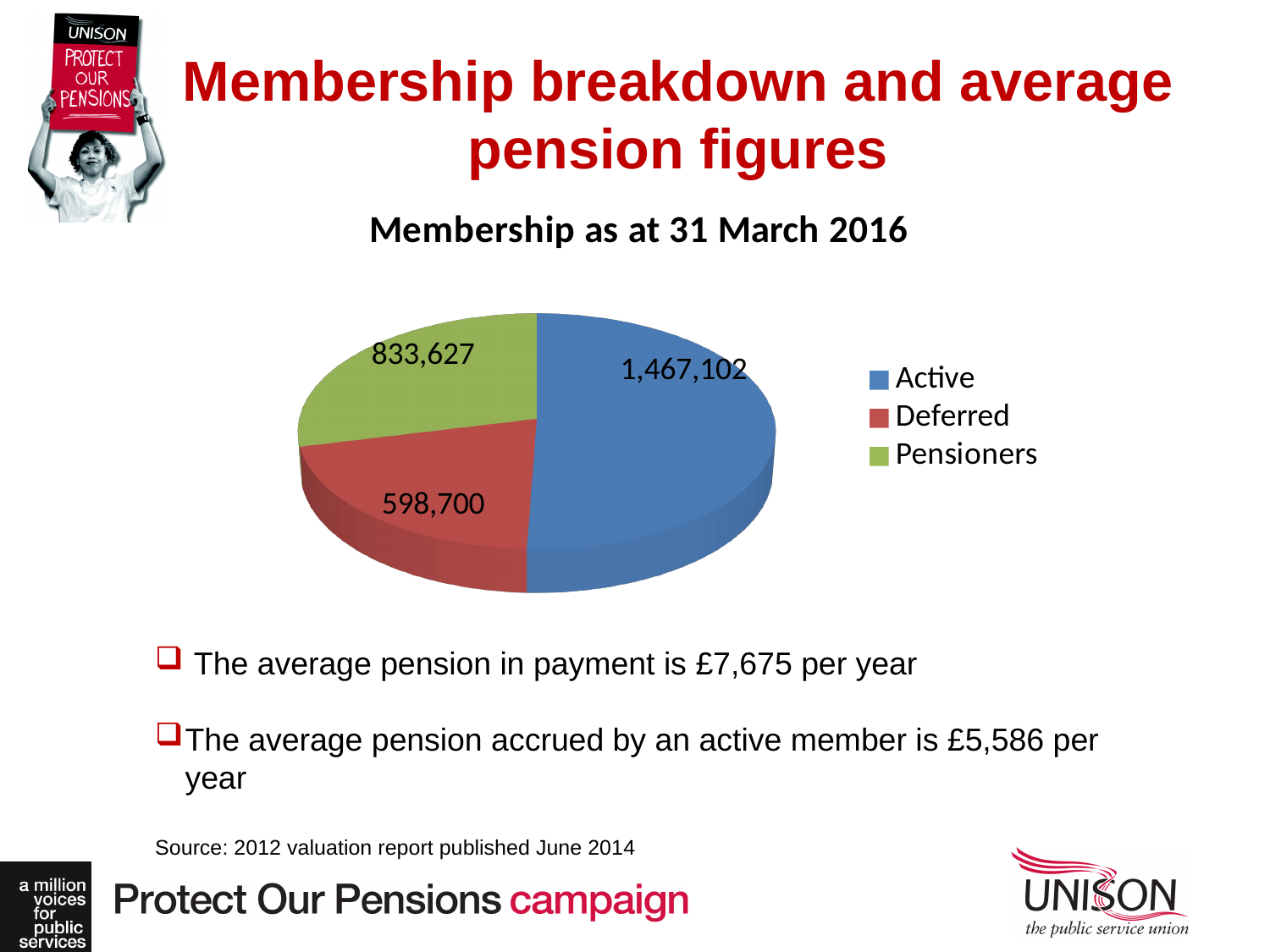
What colour is the Pensioners slice in the pie chart? Green How many slices does the pie chart have? 3 Which category has the largest slice of the pie? Active Which is larger, the value for Pensioners or the value for Deferred? Pensioners What is the value shown for Active members? 1,467,102 What is the difference between the Active value and the Deferred value? 868,402 What type of chart is shown on the slide? Pie chart What is the title of the chart? Membership as at 31 March 2016 How many entries does the chart legend list? 3 What is the value shown for Pensioners? 833,627 What is the value shown for Deferred members? 598,700 Which category has the smallest slice of the pie? Deferred